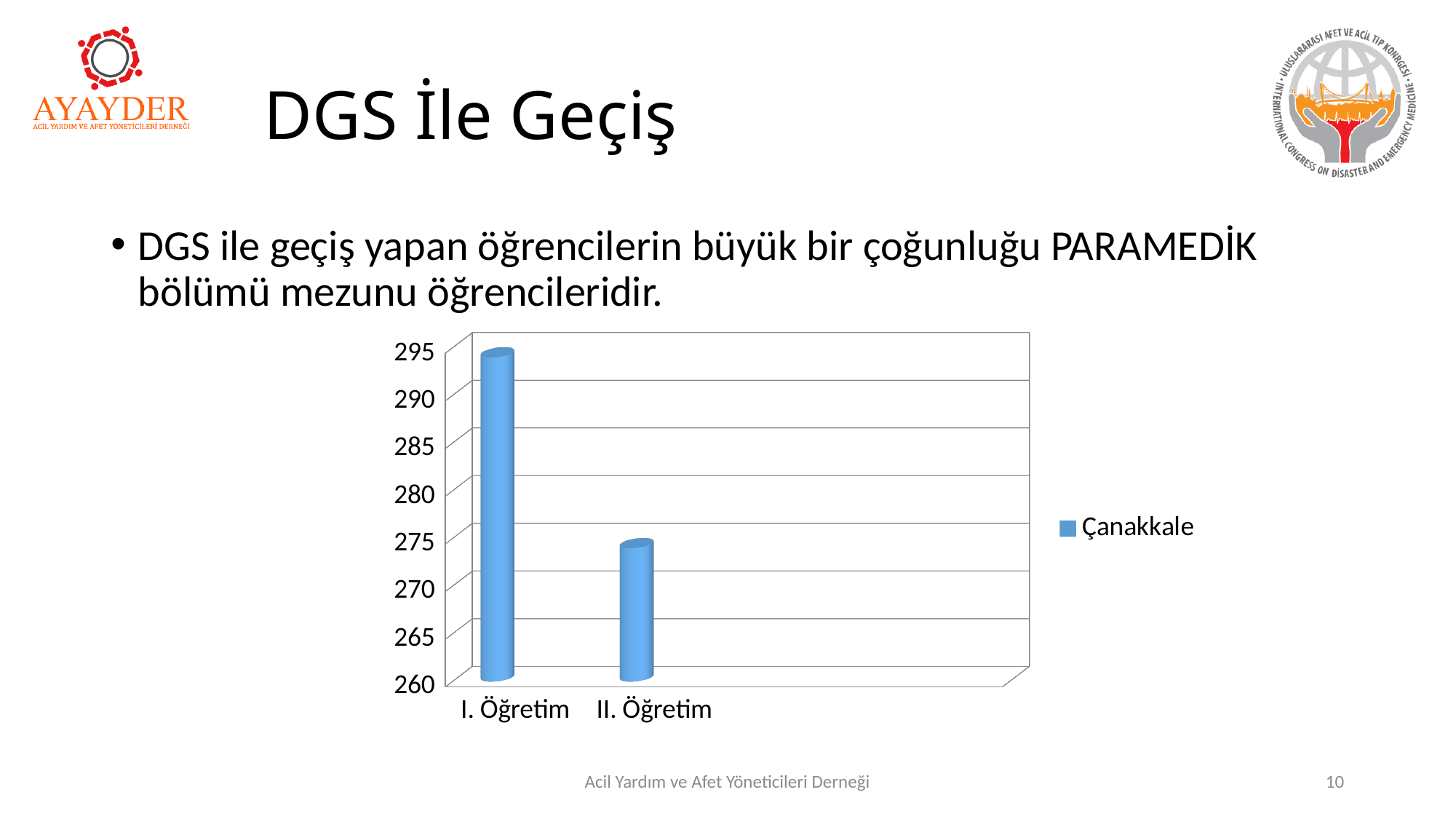
Is the value for II. Öğretim greater or less than 280? less Which category has the highest value in the chart? I. Öğretim Is the value for II. Öğretim greater or less than 270? greater Which is larger, the value for I. Öğretim or the value for II. Öğretim? I. Öğretim What series name is shown in the chart legend? Çanakkale What is the lowest value shown on the chart's vertical axis? 260 Is the value for I. Öğretim greater or less than 290? greater What kind of chart is shown on the slide? bar chart Which category has the lowest value in the chart? II. Öğretim How many categories are shown on the x axis of the chart? 2 How many series does the chart legend list? 1 Do the values rise or fall from I. Öğretim to II. Öğretim? fall